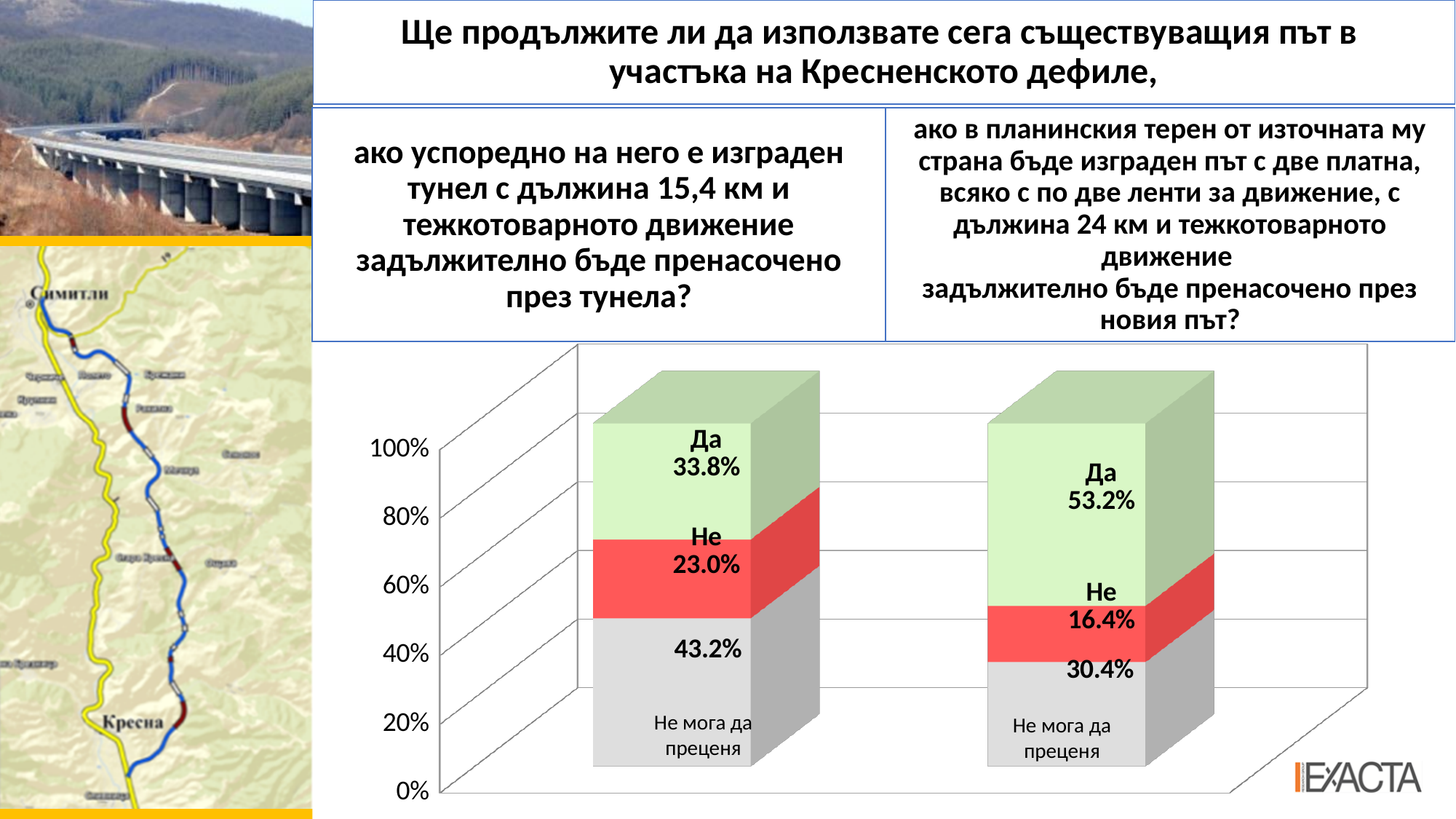
What is the value of the "Не мога да преценя" segment in the left bar? 43.2% Which segment is the smallest in the right bar? Не Which bar has the larger "Не" value, the left or the right? left What is the value of the "Не мога да преценя" segment in the right bar? 30.4% Which segment is the largest in the left bar? Не мога да преценя What is the value of the "Да" segment in the right bar? 53.2% What kind of chart is shown on the slide? stacked bar chart What is the difference between the "Да" values of the right bar and the left bar? 19.4% What is the value of the "Не" segment in the left bar? 23.0% What is the value of the "Да" segment in the left bar? 33.8% What is the value of the "Не" segment in the right bar? 16.4% How many bars does the chart show? 2